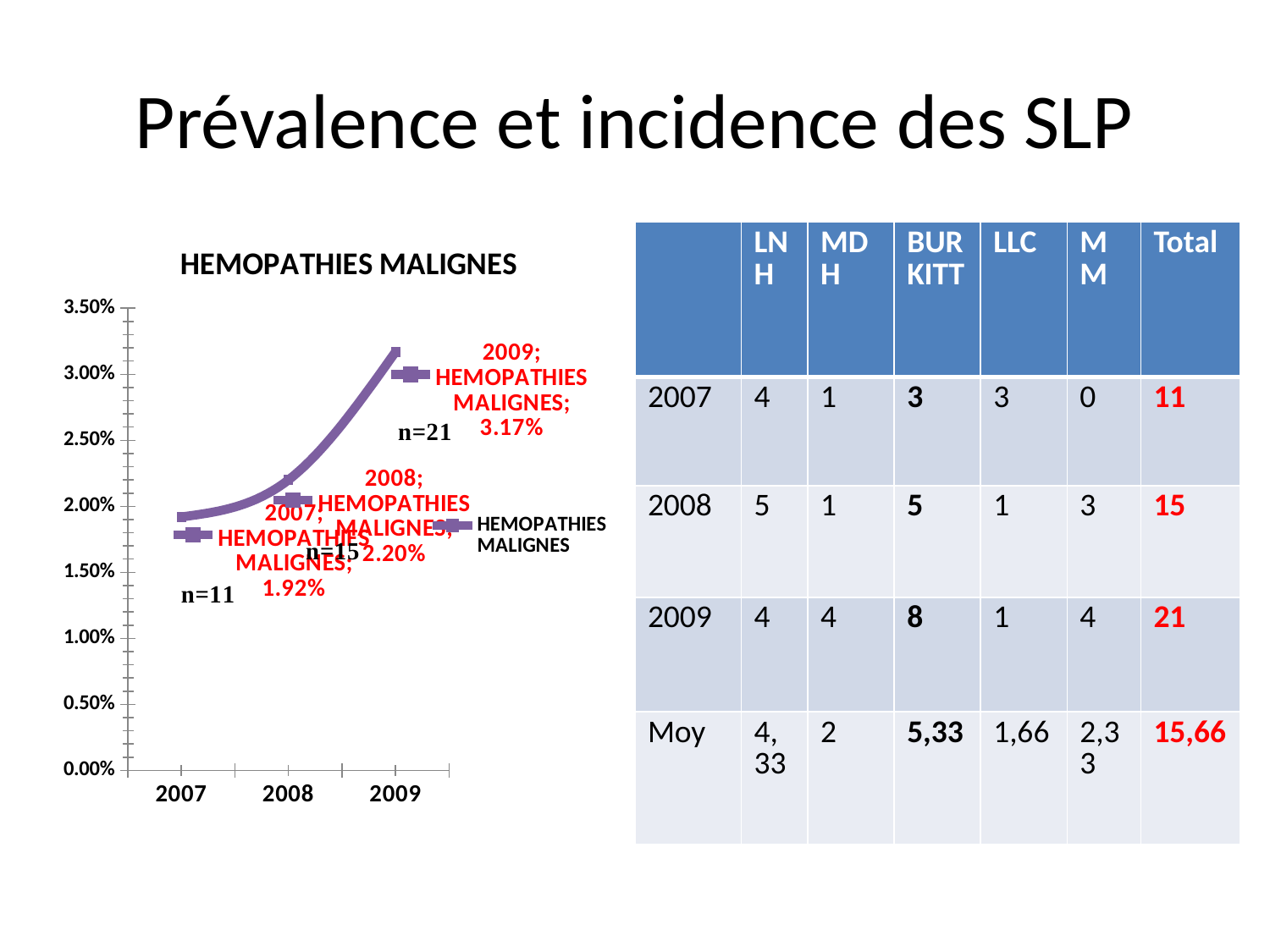
Which year has the lowest value in the HEMOPATHIES MALIGNES chart? 2007 What is the difference between the 2009 and 2007 values in the HEMOPATHIES MALIGNES chart? 1.25% Which year has the highest value in the HEMOPATHIES MALIGNES chart? 2009 What is the value for 2009 in the HEMOPATHIES MALIGNES chart? 3.17% What kind of chart is the HEMOPATHIES MALIGNES chart? line chart What is the value for 2007 in the HEMOPATHIES MALIGNES chart? 1.92% What is the value for 2008 in the HEMOPATHIES MALIGNES chart? 2.20% How many years are plotted on the x axis of the HEMOPATHIES MALIGNES chart? 3 Is the value for 2009 in the HEMOPATHIES MALIGNES chart greater or less than 3.00%? greater How many series does the legend of the HEMOPATHIES MALIGNES chart list? 1 Do the values in the HEMOPATHIES MALIGNES chart rise or fall from 2007 to 2009? rise In the HEMOPATHIES MALIGNES chart, is the value for 2008 or 2009 larger? 2009